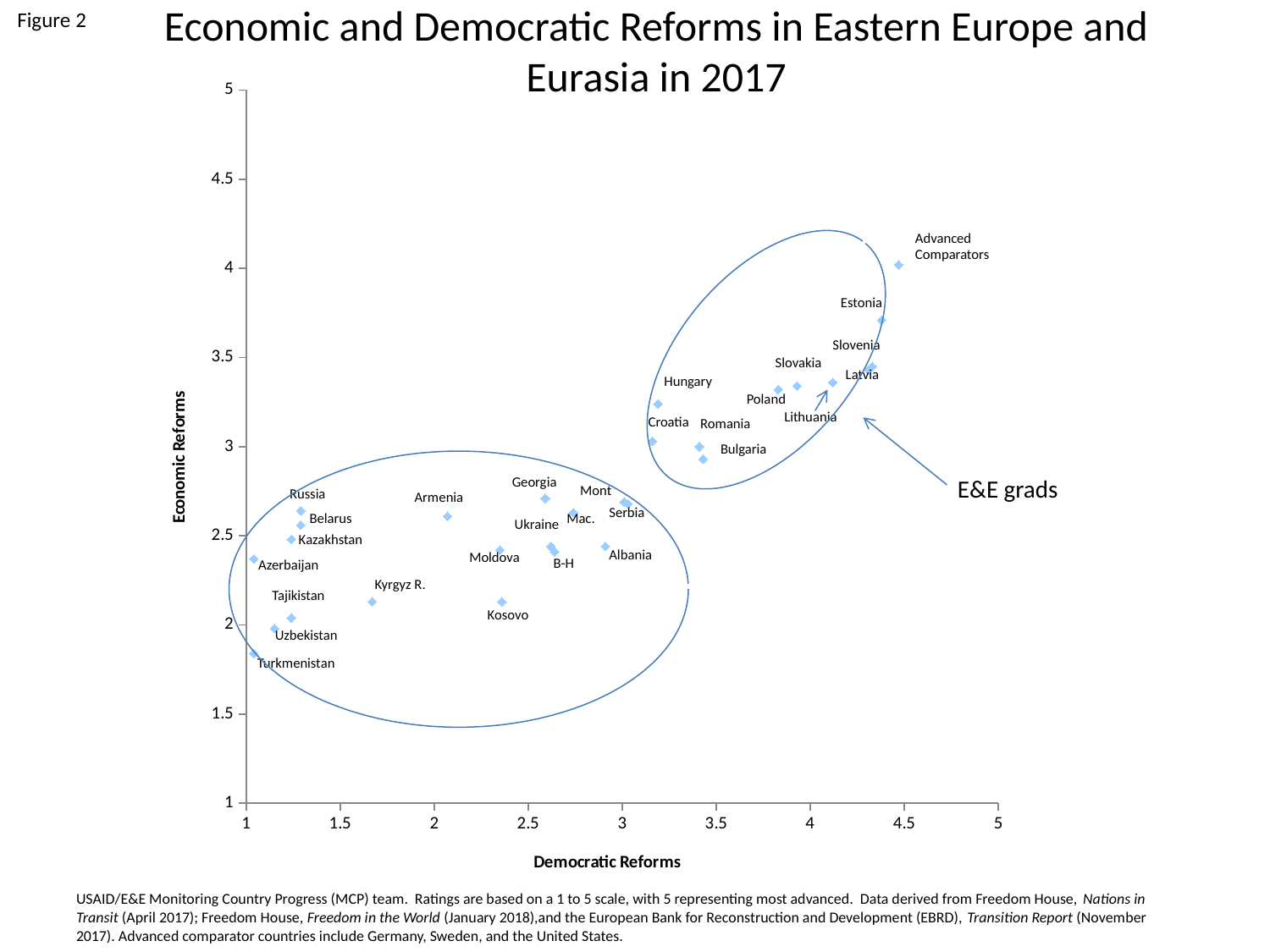
Which has a higher Democratic Reforms value, Kosovo or Turkmenistan? Kosovo Which point has the highest Economic Reforms value? Advanced Comparators What is the label of the horizontal axis? Democratic Reforms Is the Democratic Reforms value for Russia greater or less than 1.5? less Which country has the lowest Economic Reforms value? Turkmenistan Is the Economic Reforms value for Estonia greater or less than 3.5? greater Is the Democratic Reforms value for Advanced Comparators greater or less than 4? greater Which has a higher Economic Reforms value, Estonia or Hungary? Estonia What kind of chart is shown on the slide? Scatter chart What is the title of the chart? Economic and Democratic Reforms in Eastern Europe and Eurasia in 2017 As Democratic Reforms increase along the x axis, do Economic Reforms generally rise or fall? rise